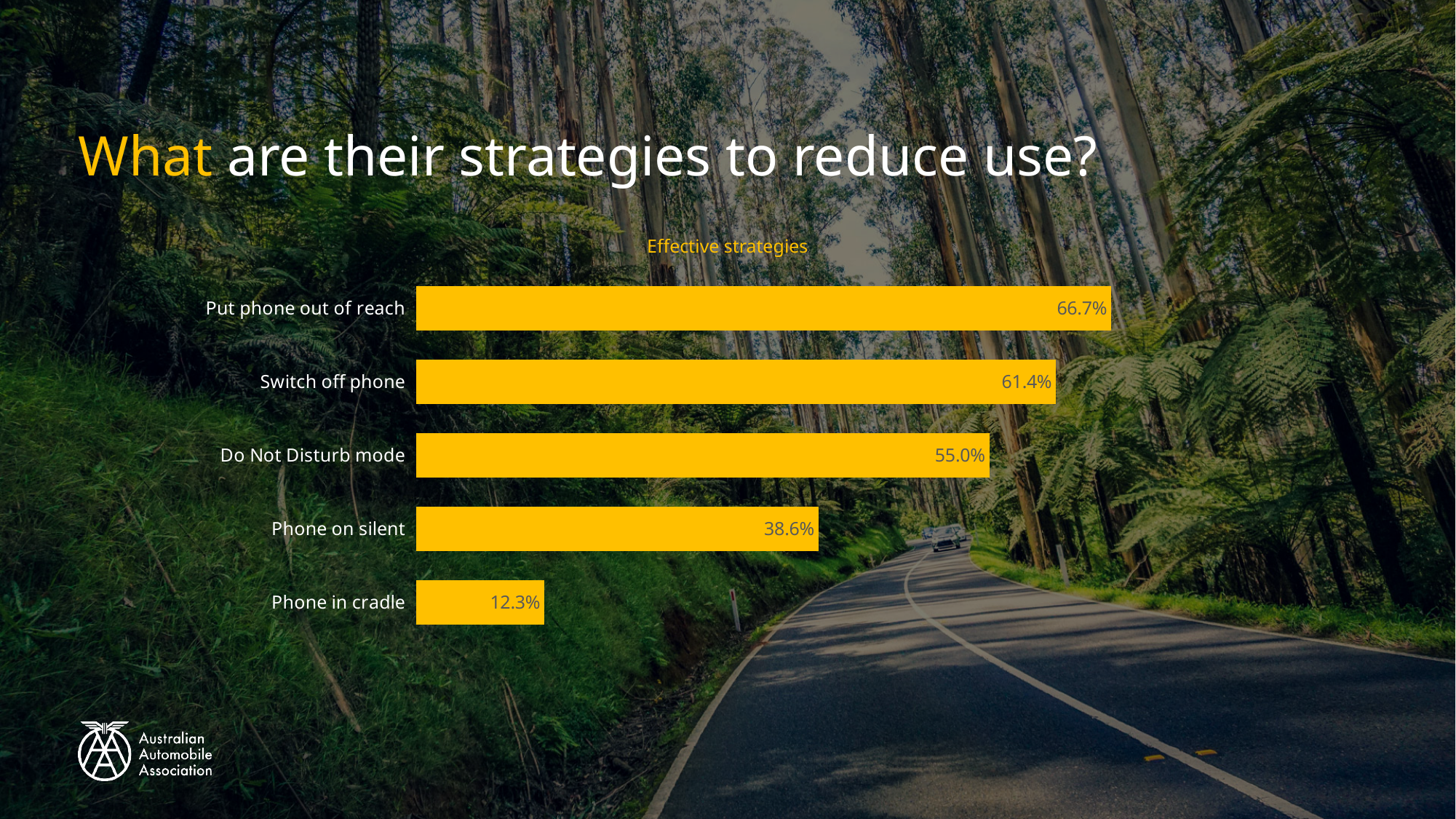
What is the value for Do Not Disturb mode? 55.0% What is the value for Switch off phone? 61.4% What is the difference between Put phone out of reach and Switch off phone? 5.3% What is the value for Phone in cradle? 12.3% What is the title of the chart? Effective strategies Which strategy has the highest value? Put phone out of reach What is the difference between Phone on silent and Phone in cradle? 26.3% What is the value for Put phone out of reach? 66.7% What kind of chart is shown on the slide? Bar chart Which strategy has the lowest value? Phone in cradle How many strategies are shown in the chart? 5 Which is larger, Do Not Disturb mode or Phone on silent? Do Not Disturb mode